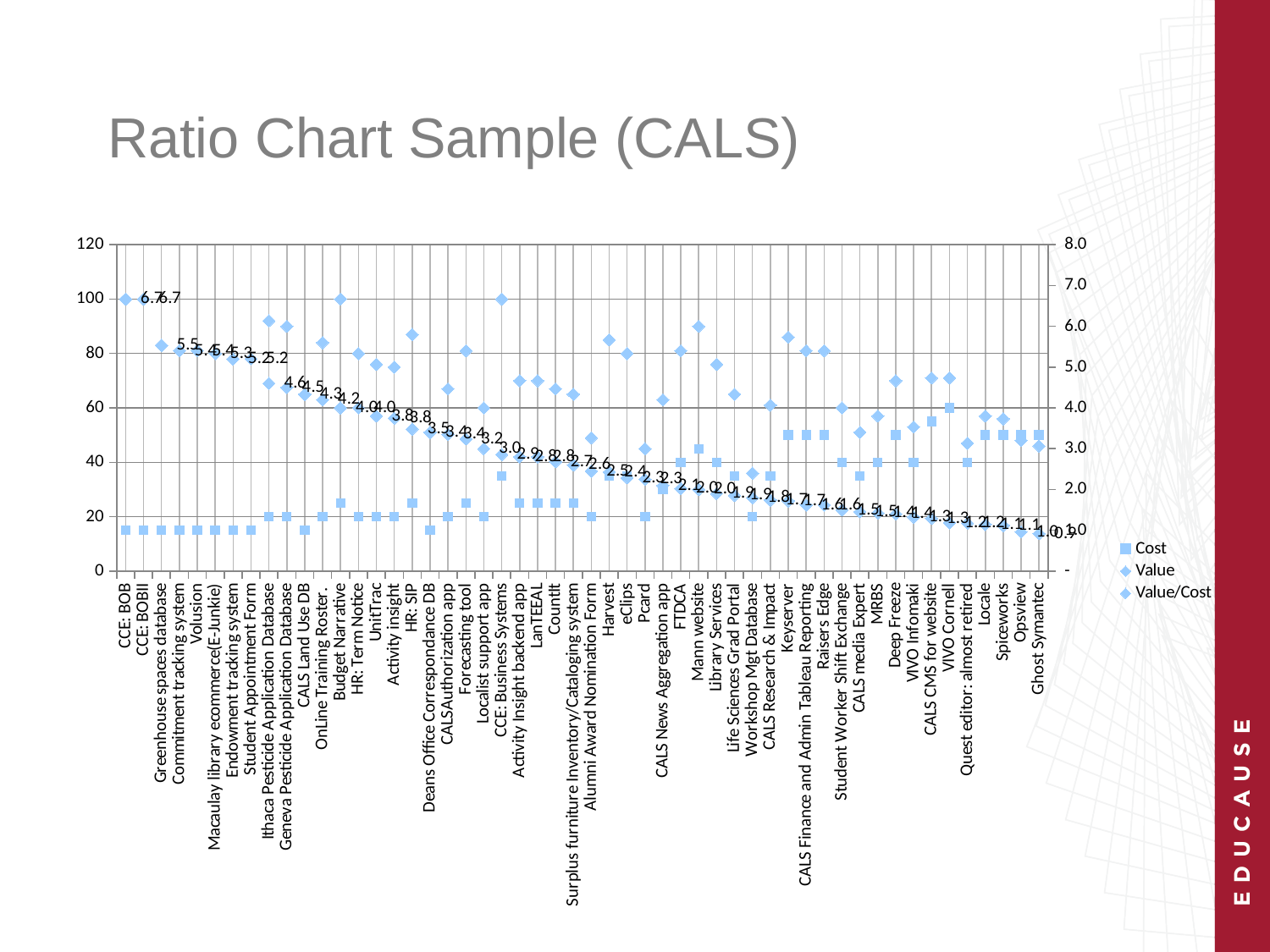
Which is larger, the Cost for Keyserver or the Cost for CCE: BOB? Keyserver Which category has the lowest Value/Cost ratio? Ghost Symantec How many series does the legend list? 3 Do the Value/Cost values rise or fall moving left to right along the x axis? fall Is the Cost value for Keyserver greater or less than 40? greater What is the Value/Cost ratio for CCE: BOB? 6.7 Is the Cost value for CCE: BOB greater or less than 20? less Is the Value for CCE: BOB greater or less than 80? greater What is the maximum value shown on the right-hand vertical axis? 8.0 What is the title of the chart? Ratio Chart Sample (CALS) What are the three series named in the legend? Cost, Value, Value/Cost Which is larger, the Value for CCE: BOB or the Value for Ghost Symantec? CCE: BOB